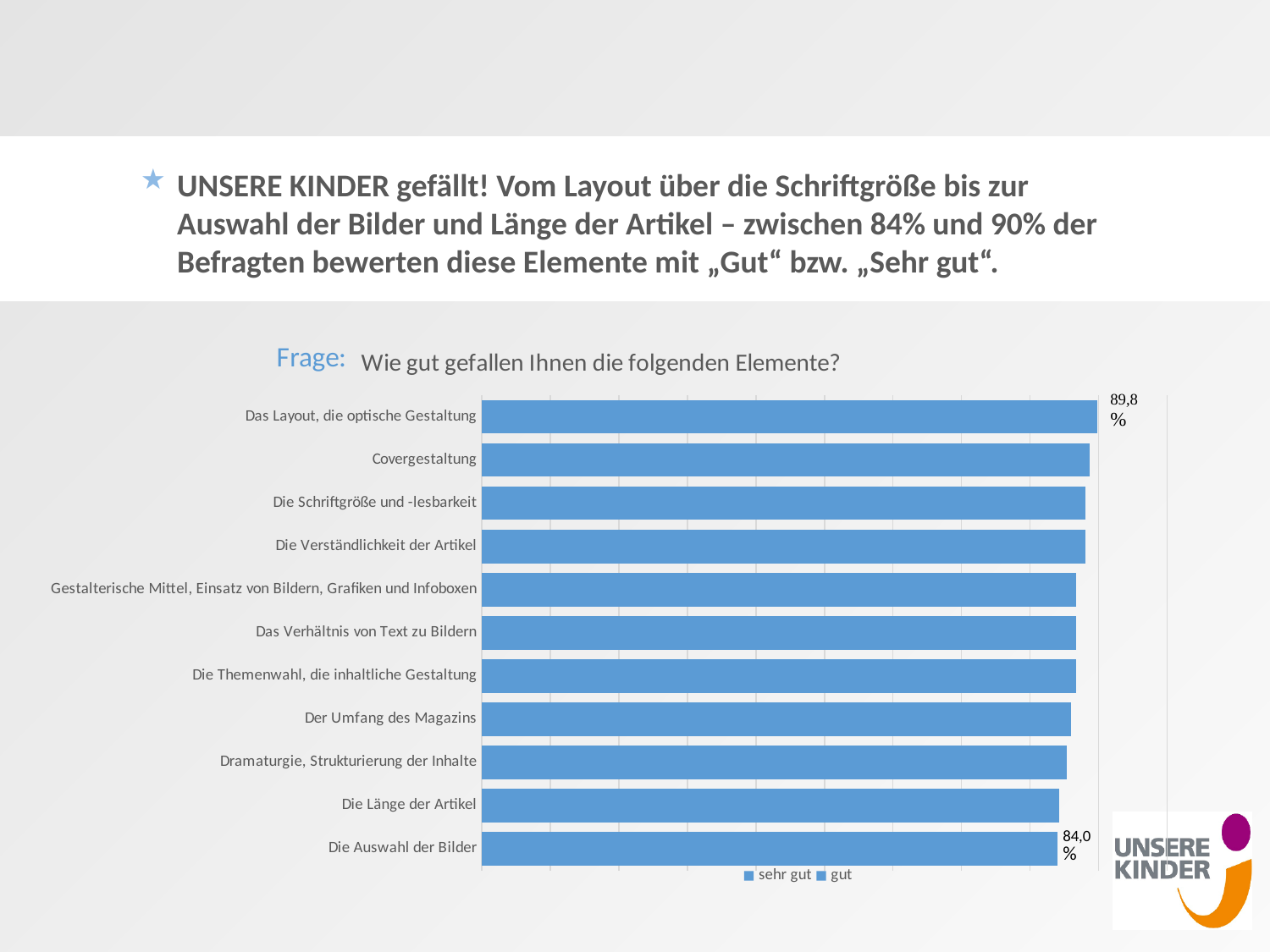
What value is shown for "Die Auswahl der Bilder"? 84,0% What value is shown for "Das Layout, die optische Gestaltung"? 89,8% What question is shown as the chart's title? Wie gut gefallen Ihnen die folgenden Elemente? Which category has the lowest value? Die Auswahl der Bilder What is the difference between the values for "Das Layout, die optische Gestaltung" and "Die Auswahl der Bilder"? 5,8% How many categories are shown in the chart? 11 Which category has the highest value? Das Layout, die optische Gestaltung Which has the larger value, "Die Schriftgröße und -lesbarkeit" or "Dramaturgie, Strukturierung der Inhalte"? Die Schriftgröße und -lesbarkeit Which has the larger value, "Covergestaltung" or "Die Länge der Artikel"? Covergestaltung Do the bar values increase or decrease from the top category to the bottom category? Decrease How many series does the legend list? 2 What kind of chart is shown on the slide? Bar chart